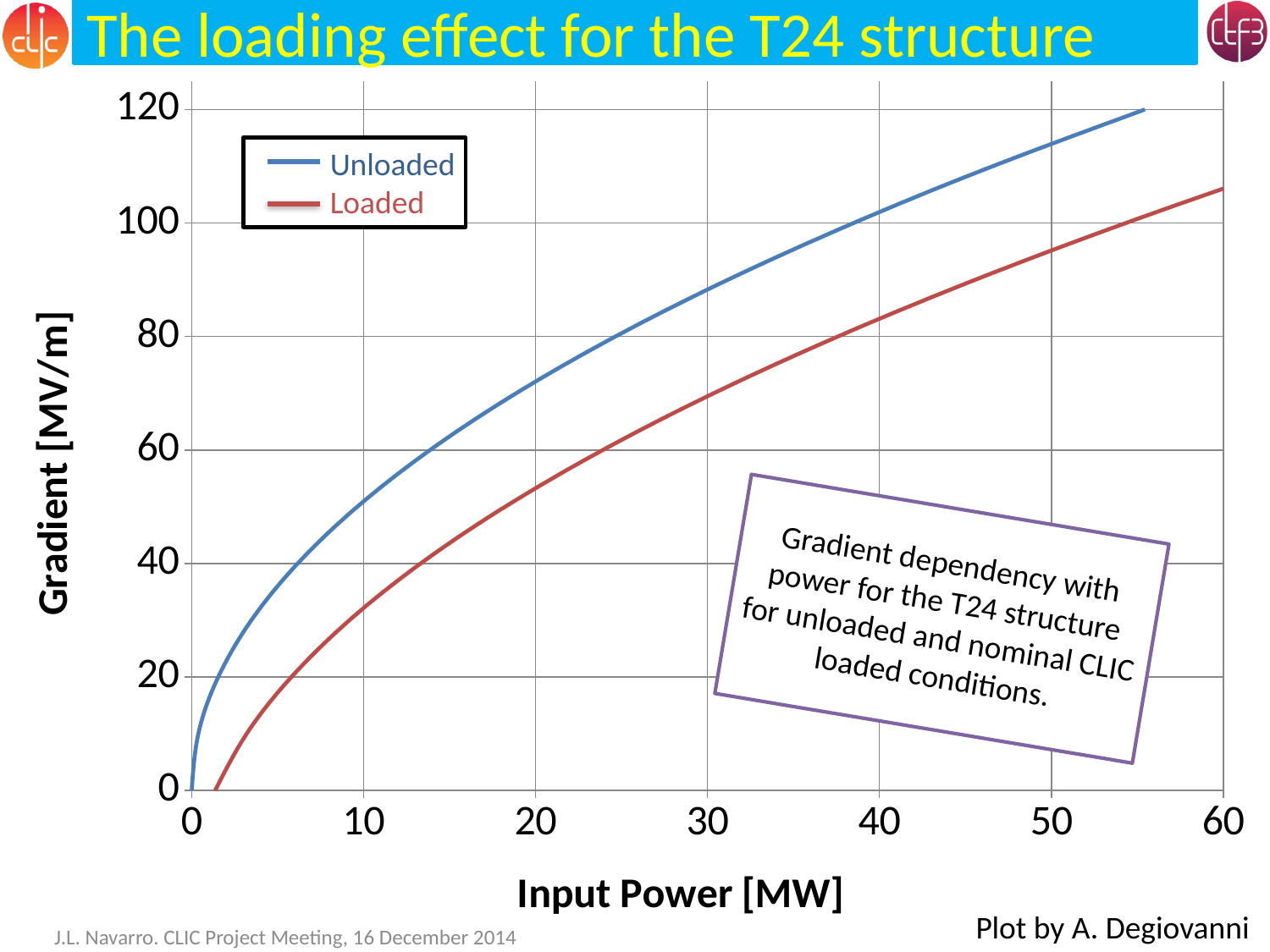
Does the Unloaded gradient rise or fall as input power increases? Rise Does the Loaded gradient rise or fall as input power increases? Rise What are the two series named in the legend? Unloaded and Loaded Is the Unloaded gradient at 10 MW input power greater or less than 40 MV/m? greater What kind of chart is shown on the slide? Line chart Is the Loaded gradient at 60 MW input power greater or less than 100 MV/m? greater Is the Loaded gradient at 10 MW input power greater or less than 40 MV/m? less What is the label of the y axis? Gradient [MV/m] At an input power of 30 MW, which series has the higher gradient, Unloaded or Loaded? Unloaded How many series does the legend list? 2